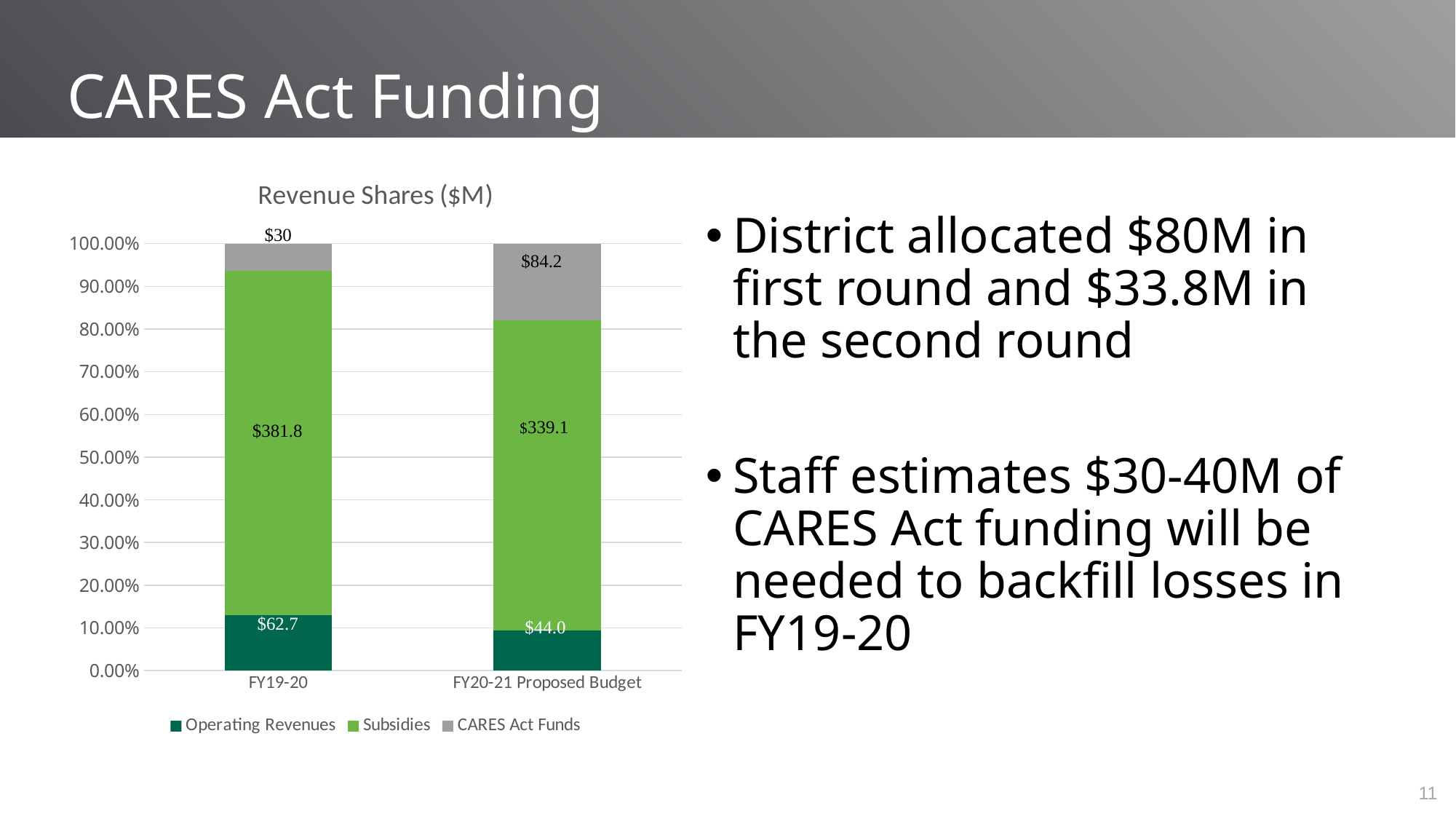
Is the Operating Revenues value larger for FY19-20 or for FY20-21 Proposed Budget? FY19-20 Which series has the largest value in the FY20-21 Proposed Budget bar? Subsidies What is the difference between the CARES Act Funds values for FY20-21 Proposed Budget and FY19-20? $54.2 What is the value of CARES Act Funds for FY19-20? $30 Which series has the smallest value in the FY19-20 bar? CARES Act Funds What is the value of Subsidies for FY19-20? $381.8 What is the value of Operating Revenues for FY19-20? $62.7 What is the value of CARES Act Funds for FY20-21 Proposed Budget? $84.2 What is the total of the FY19-20 stacked bar? $474.5 What is the difference between the Subsidies values for FY19-20 and FY20-21 Proposed Budget? $42.7 What type of chart is shown on the slide? Stacked bar chart How many series does the legend list? 3